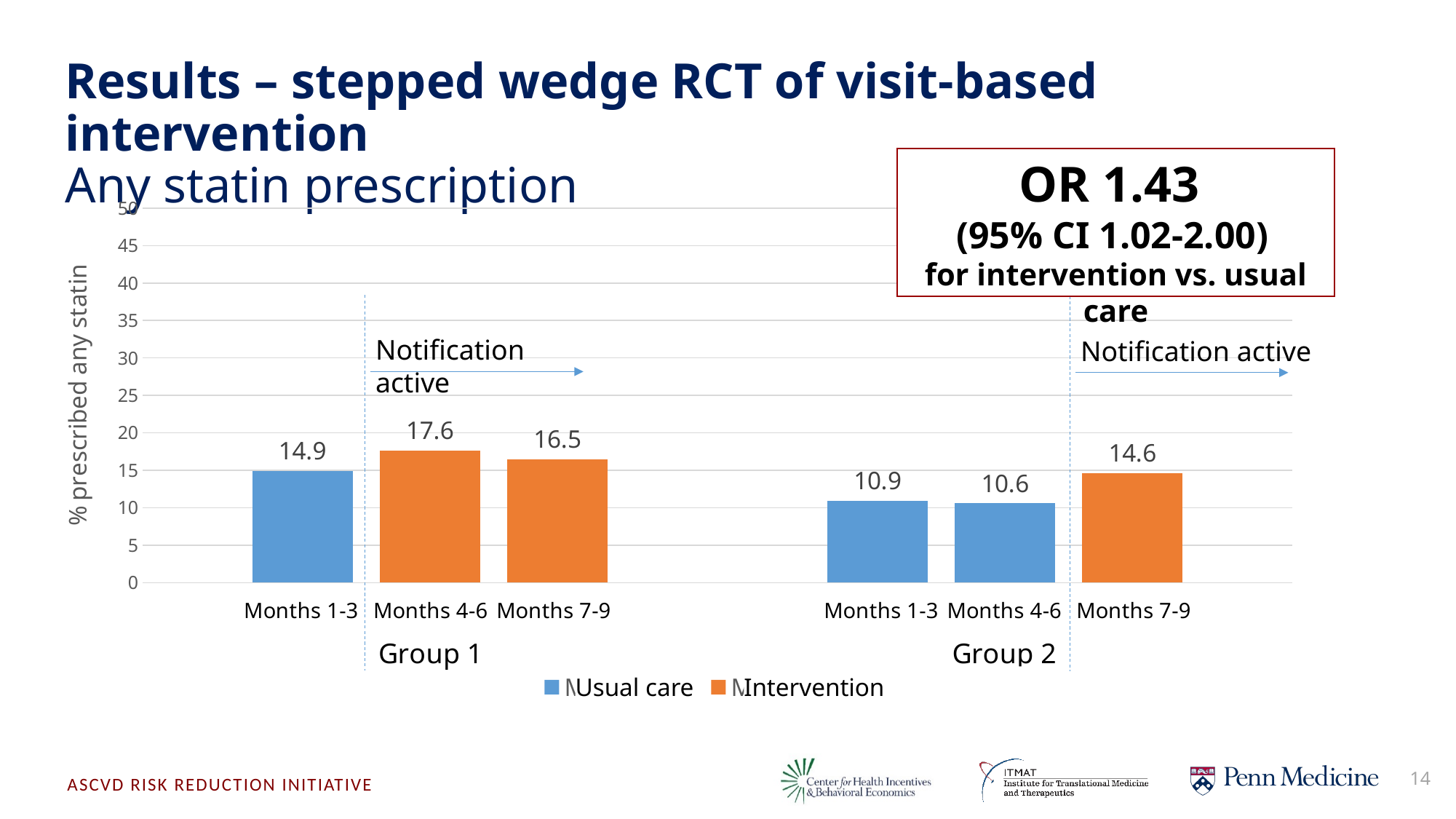
What is the value for Months 7-9 in Group 2? 14.6 Which is larger: Months 7-9 in Group 1 or Months 7-9 in Group 2? Months 7-9 in Group 1 What is the difference between the Months 7-9 and Months 4-6 values in Group 2? 4.0 What is the difference between the Months 4-6 and Months 1-3 values in Group 1? 2.7 How many series does the legend list? 2 What type of chart is shown on the slide? bar chart Which bar has the lowest value on the chart? Months 4-6, Group 2 What is the label of the y axis? % prescribed any statin What is the value for Months 1-3 in Group 1? 14.9 What is the value for Months 4-6 in Group 2? 10.6 What is the value for Months 4-6 in Group 1? 17.6 Which bar has the highest value on the chart? Months 4-6, Group 1